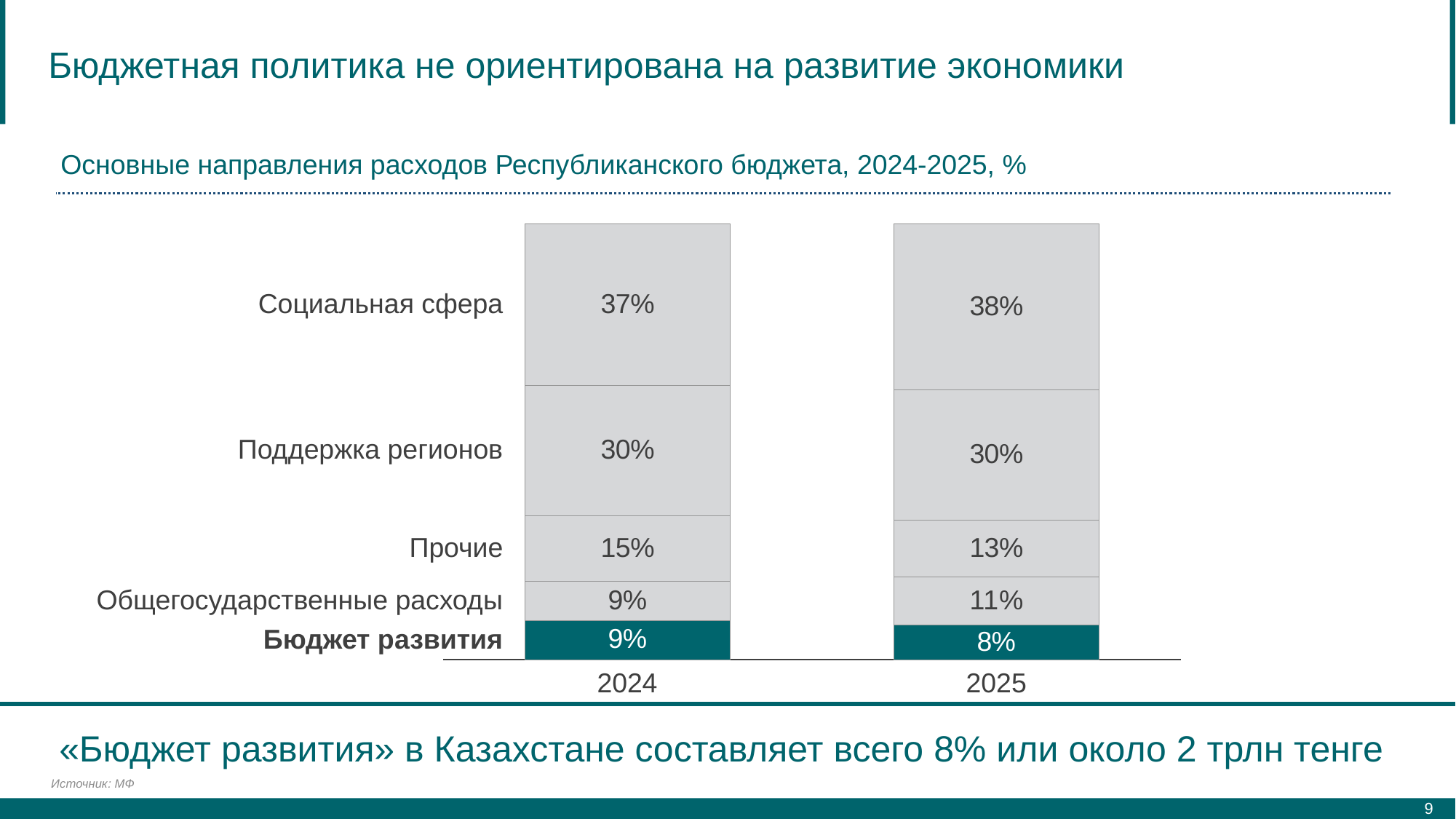
How many categories (segments) are shown in each stacked bar? 5 What type of chart is shown on the slide? Stacked bar chart What is the share of Социальная сфера in 2024? 37% What is the share of Общегосударственные расходы in 2025? 11% Which is larger: the share of Поддержка регионов in 2024 or the share of Социальная сфера in 2024? Социальная сфера in 2024 Does the share of Бюджет развития rise or fall from 2024 to 2025? Fall What is the share of Бюджет развития in 2025? 8% What is the total of the 2025 stacked bar? 100% Which category has the smallest share in 2025? Бюджет развития Which category has the largest share in 2025? Социальная сфера By how many percentage points did the share of Прочие change from 2024 to 2025? 2 What is the share of Прочие in 2024? 15%